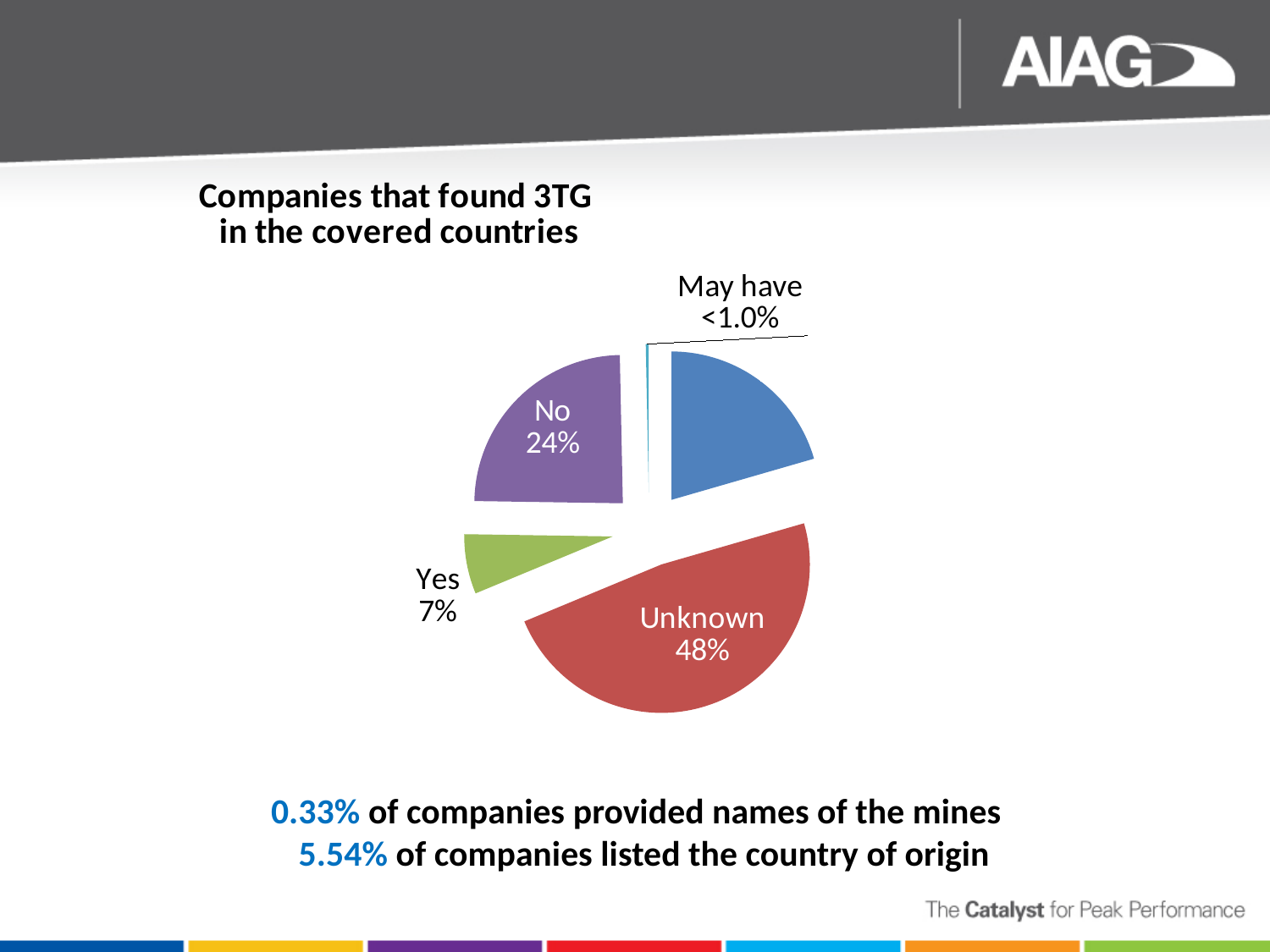
What percentage of the pie is labelled Yes? 7% How many percentage points larger is the Unknown slice than the No slice? 24% Which labelled slice has the smallest share of the pie? May have What value is shown for the May have slice? <1.0% What kind of chart is shown on the slide? pie chart Which labelled slice has the largest share of the pie? Unknown How many percentage points larger is the No slice than the Yes slice? 17% What percentage of the pie is labelled Unknown? 48% Which slice is larger, No or Yes? No What colour is the Unknown slice of the pie? red What is the title of the pie chart? Companies that found 3TG in the covered countries What percentage of the pie is labelled No? 24%